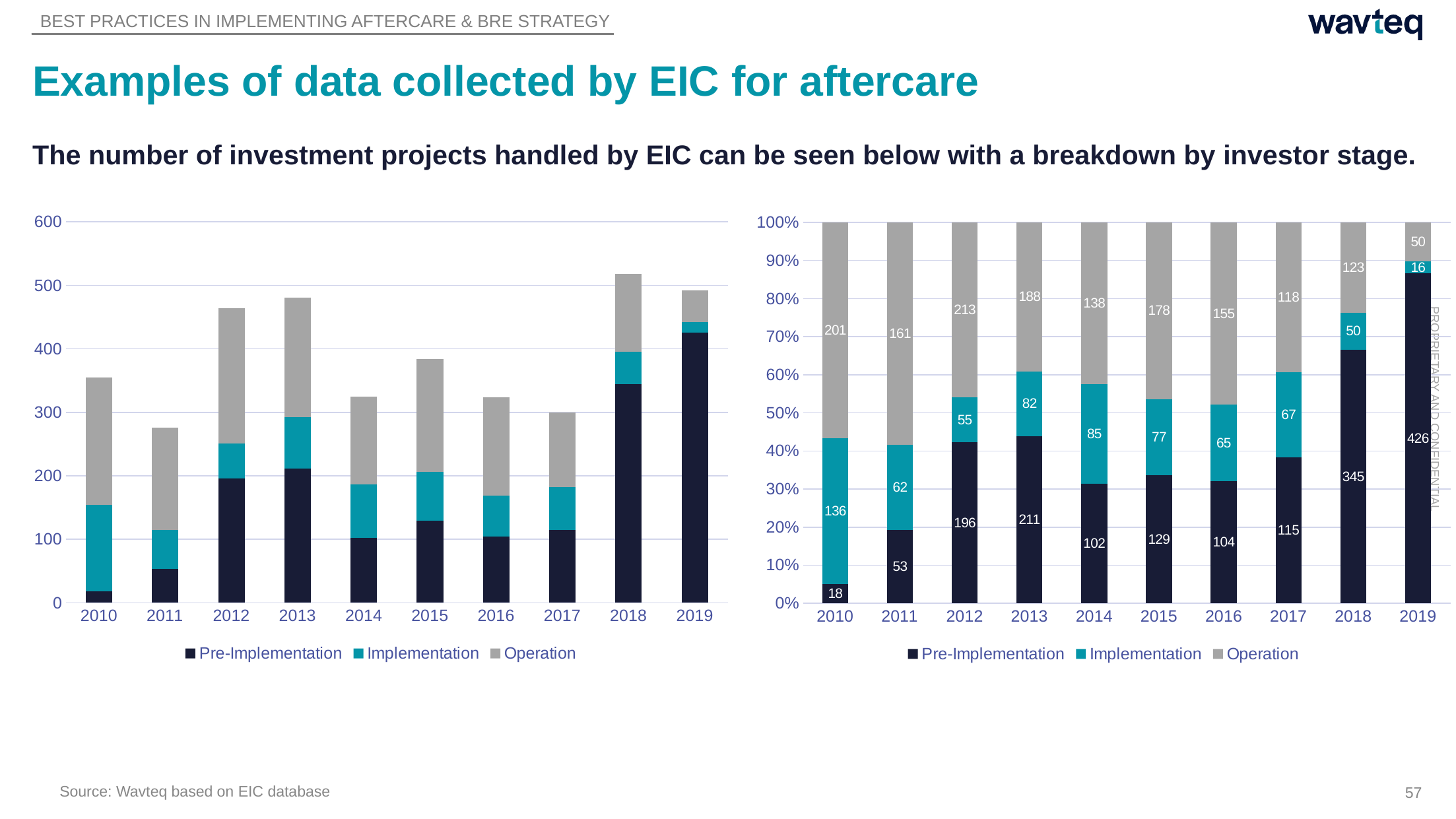
In the right-hand chart, what is the total of the three stacked values for 2010? 355 In the left-hand chart, is the total stacked bar for 2018 greater or less than 500? greater In the right-hand chart, which year has the highest Pre-Implementation value? 2019 In the right-hand chart, what is the Operation value for 2012? 213 How many series does the legend of the right-hand chart list? 3 In the left-hand chart, is the total stacked bar for 2011 greater or less than 300? less How many years are shown on the x axis of the left-hand chart? 10 In the right-hand chart, which year has the lowest Implementation value? 2019 In the right-hand chart, what is the Implementation value for 2010? 136 In the right-hand chart, what is the Pre-Implementation value for 2019? 426 In the right-hand chart, which is larger: the Operation value for 2013 or the Operation value for 2015? 2013 In the right-hand chart, what is the difference between the Pre-Implementation values for 2019 and 2018? 81